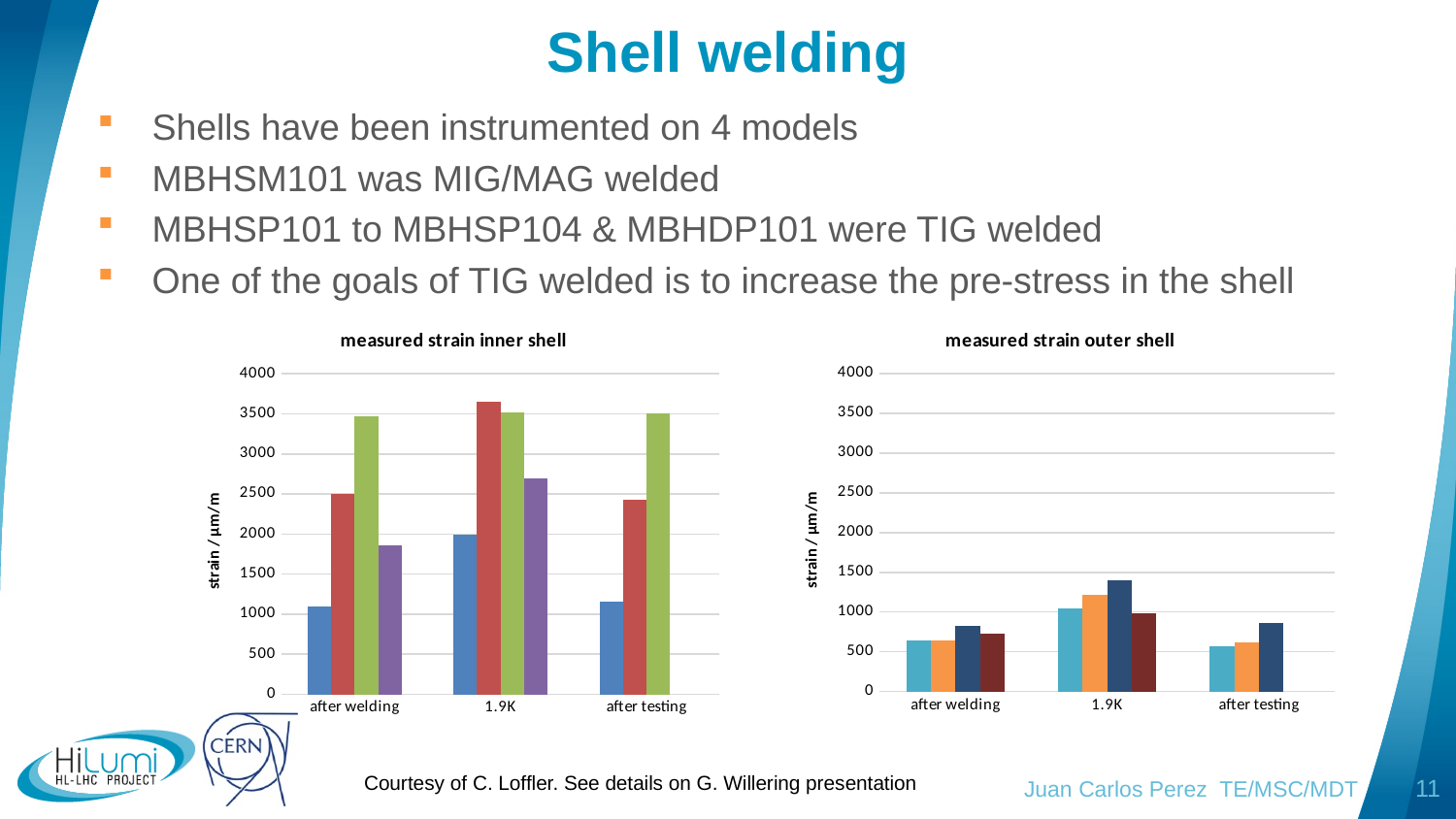
What kind of chart is the 'measured strain inner shell' chart? bar chart What is the y-axis label of the 'measured strain outer shell' chart? strain / µm/m How many categories are shown on the x axis of the 'measured strain outer shell' chart? 3 In the 'measured strain outer shell' chart, which category contains the tallest bar? 1.9K In the 'measured strain inner shell' chart, is the purple bar for '1.9K' greater or less than 2500? greater In the 'measured strain inner shell' chart, is the green bar for 'after welding' greater or less than 3000? greater In the 'measured strain inner shell' chart, how many bars are shown for the 'after testing' category? 3 In the 'measured strain inner shell' chart, is the blue bar for '1.9K' greater or less than 1500? greater In the 'measured strain inner shell' chart, is the blue bar larger for '1.9K' or for 'after welding'? 1.9K What is the title of the chart on the left of the slide? measured strain inner shell